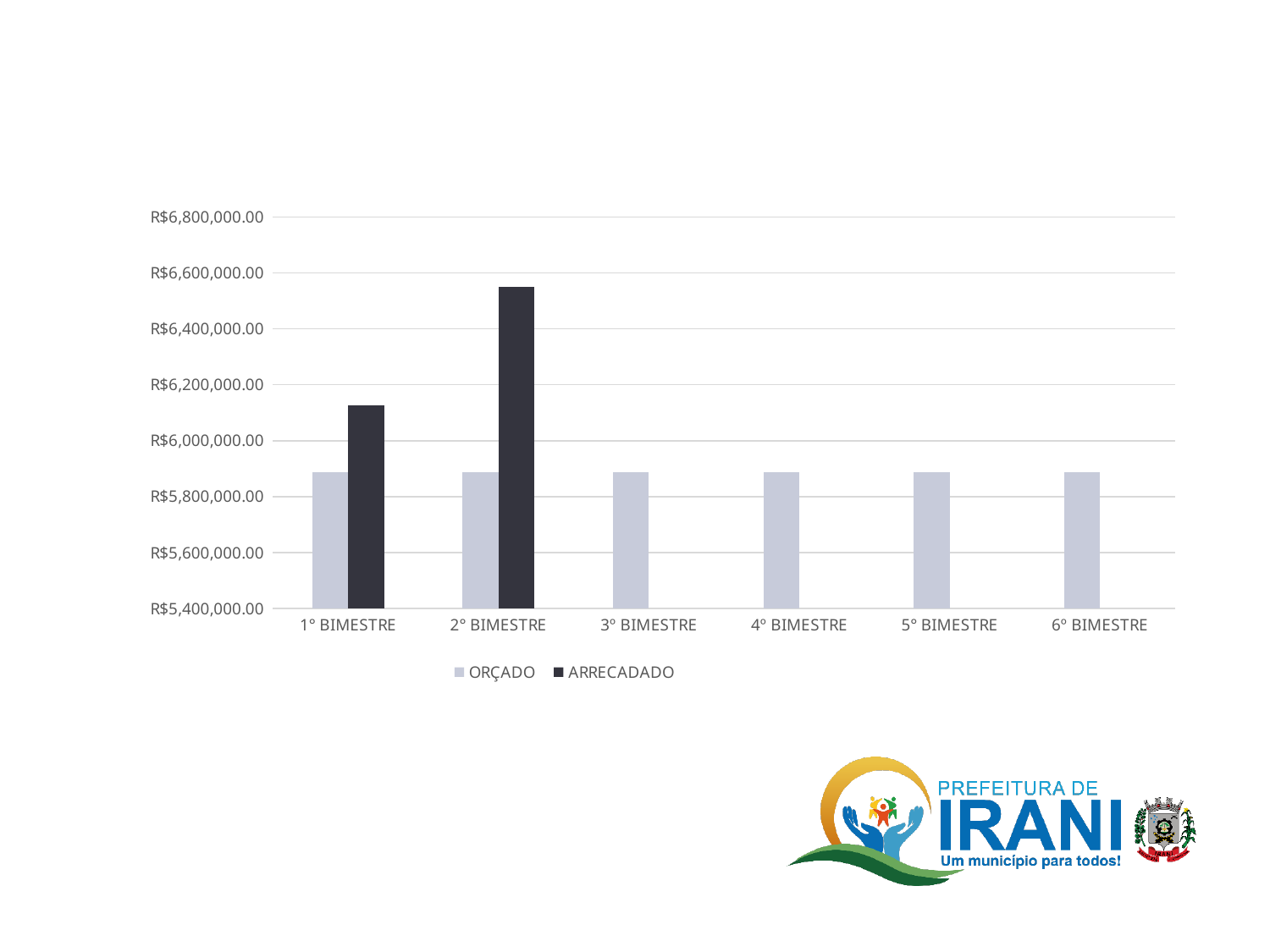
How many series does the legend list? 2 Which is larger, the ARRECADADO value for 1º BIMESTRE or for 2º BIMESTRE? 2º BIMESTRE Is the ARRECADADO value for 2º BIMESTRE greater or less than R$6,400,000.00? greater Which bimestre has the highest ARRECADADO value? 2º BIMESTRE For 1º BIMESTRE, which is larger, ORÇADO or ARRECADADO? ARRECADADO Is the ORÇADO value for 3º BIMESTRE greater or less than R$6,000,000.00? less Does the ARRECADADO value rise or fall from 1º BIMESTRE to 2º BIMESTRE? rise What kind of chart is shown on the slide? bar chart What are the two series named in the legend? ORÇADO and ARRECADADO How many bimestre categories are shown on the x axis? 6 Is the ARRECADADO value for 1º BIMESTRE greater or less than R$6,000,000.00? greater